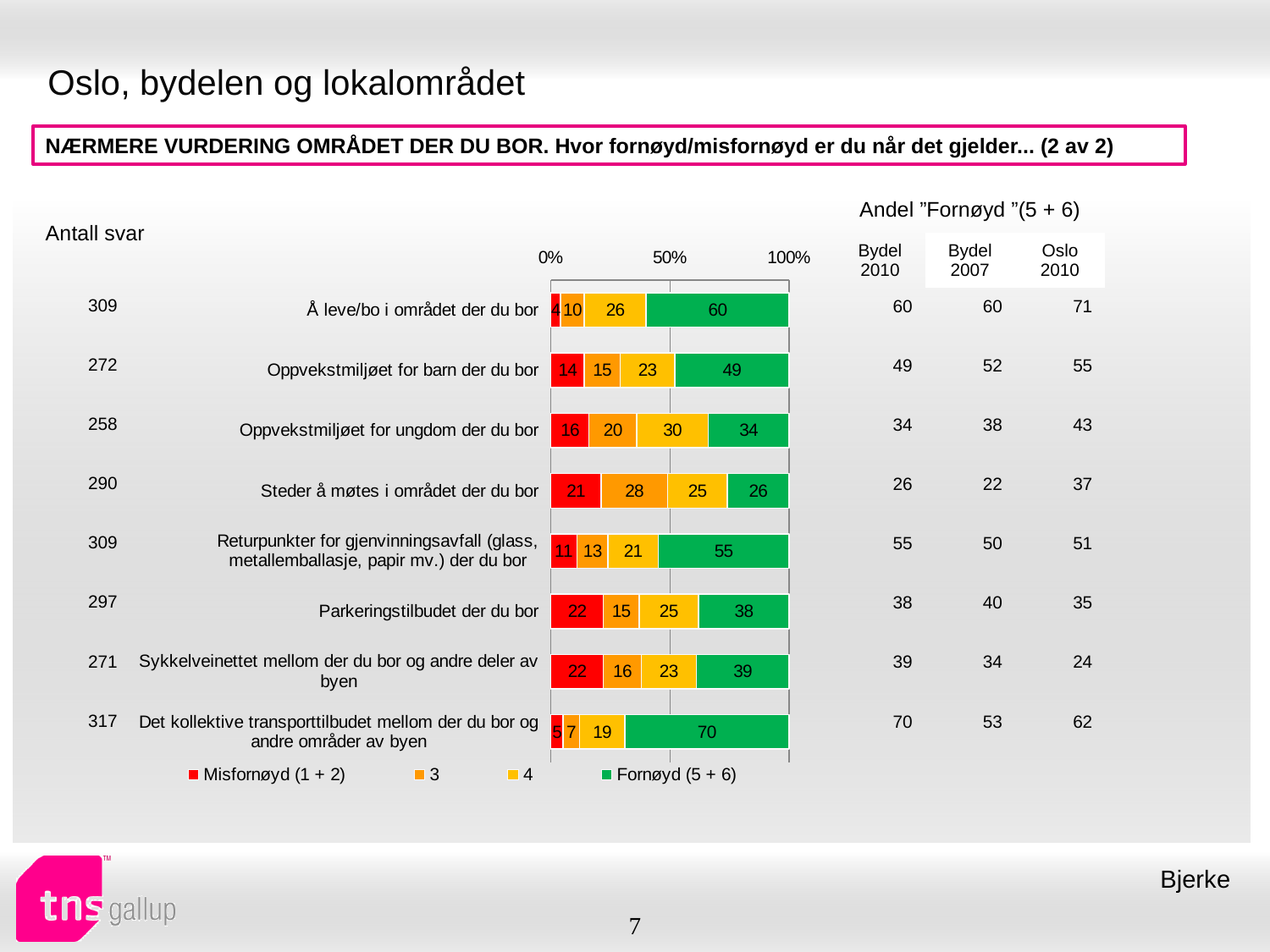
Which category has the lowest Fornøyd (5 + 6) value? Steder å møtes i området der du bor Which series is shown in green in the chart? Fornøyd (5 + 6) What is the value of the Misfornøyd (1 + 2) segment for "Parkeringstilbudet der du bor"? 22 Which has a larger Misfornøyd (1 + 2) value: "Oppvekstmiljøet for ungdom der du bor" or "Returpunkter for gjenvinningsavfall (glass, metallemballasje, papir mv.) der du bor"? Oppvekstmiljøet for ungdom der du bor Which category has the highest Fornøyd (5 + 6) value? Det kollektive transporttilbudet mellom der du bor og andre områder av byen What is the value of the Fornøyd (5 + 6) segment for "Å leve/bo i området der du bor"? 60 How many series does the chart legend list? 4 How many categories are shown in the chart? 8 What kind of chart is shown on the slide? Stacked bar chart What is the value of the "3" segment for "Steder å møtes i området der du bor"? 28 What is the difference between the Fornøyd (5 + 6) values for "Oppvekstmiljøet for barn der du bor" and "Oppvekstmiljøet for ungdom der du bor"? 15 What is the total of the stacked bar for "Å leve/bo i området der du bor"? 100